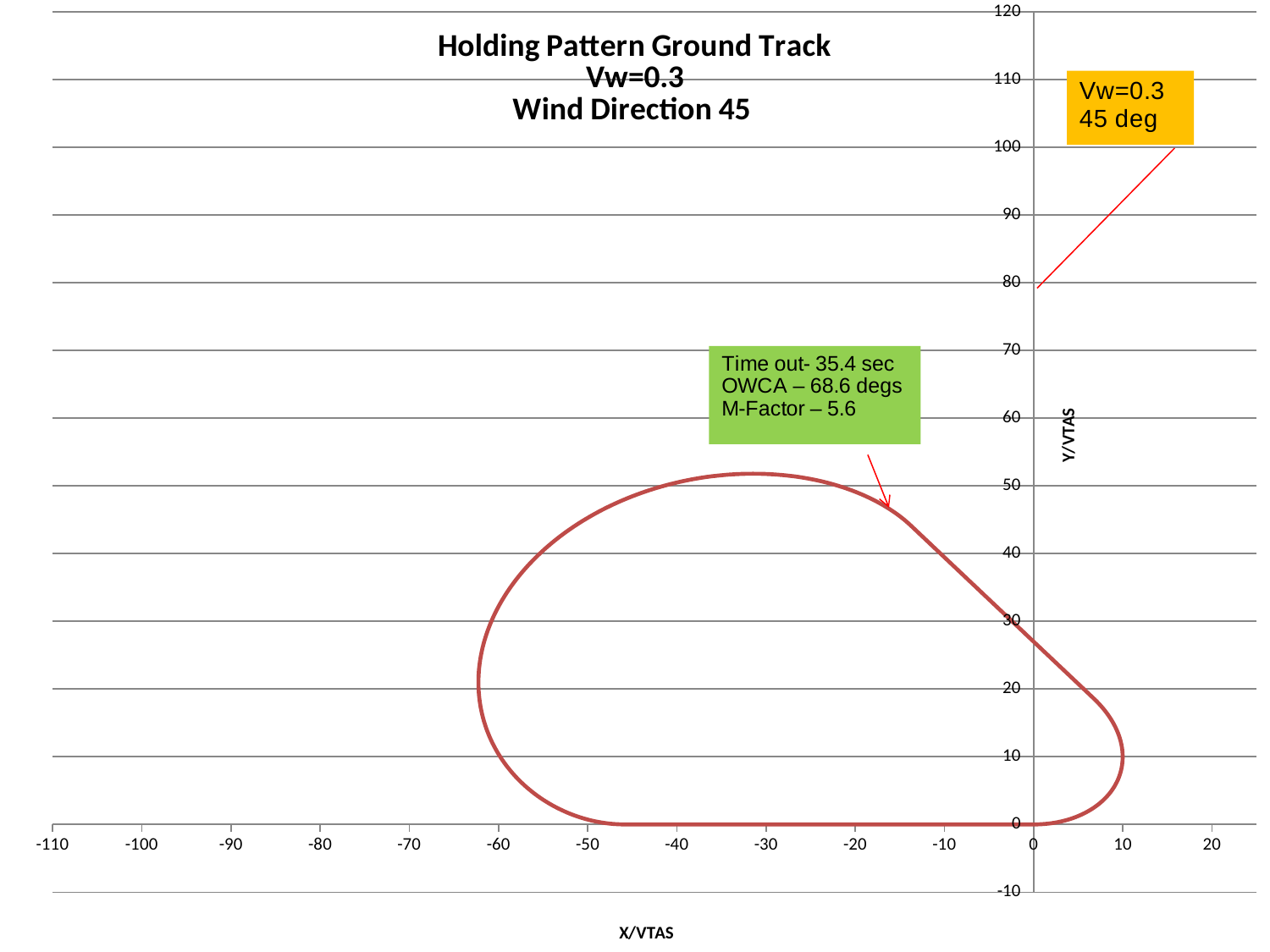
What is the title of the chart? Holding Pattern Ground Track Vw=0.3 Wind Direction 45 At X/VTAS = -30, is the upper part of the ground track greater or less than 40 on the Y/VTAS axis? greater Is the largest X/VTAS value reached by the ground track greater or less than 20? less What Time out value is given in the green annotation box on the chart? 35.4 sec What is the lowest Y/VTAS value the ground track reaches? 0 Is the highest Y/VTAS value reached by the ground track greater or less than 60? less What kind of chart is shown on the slide? line chart